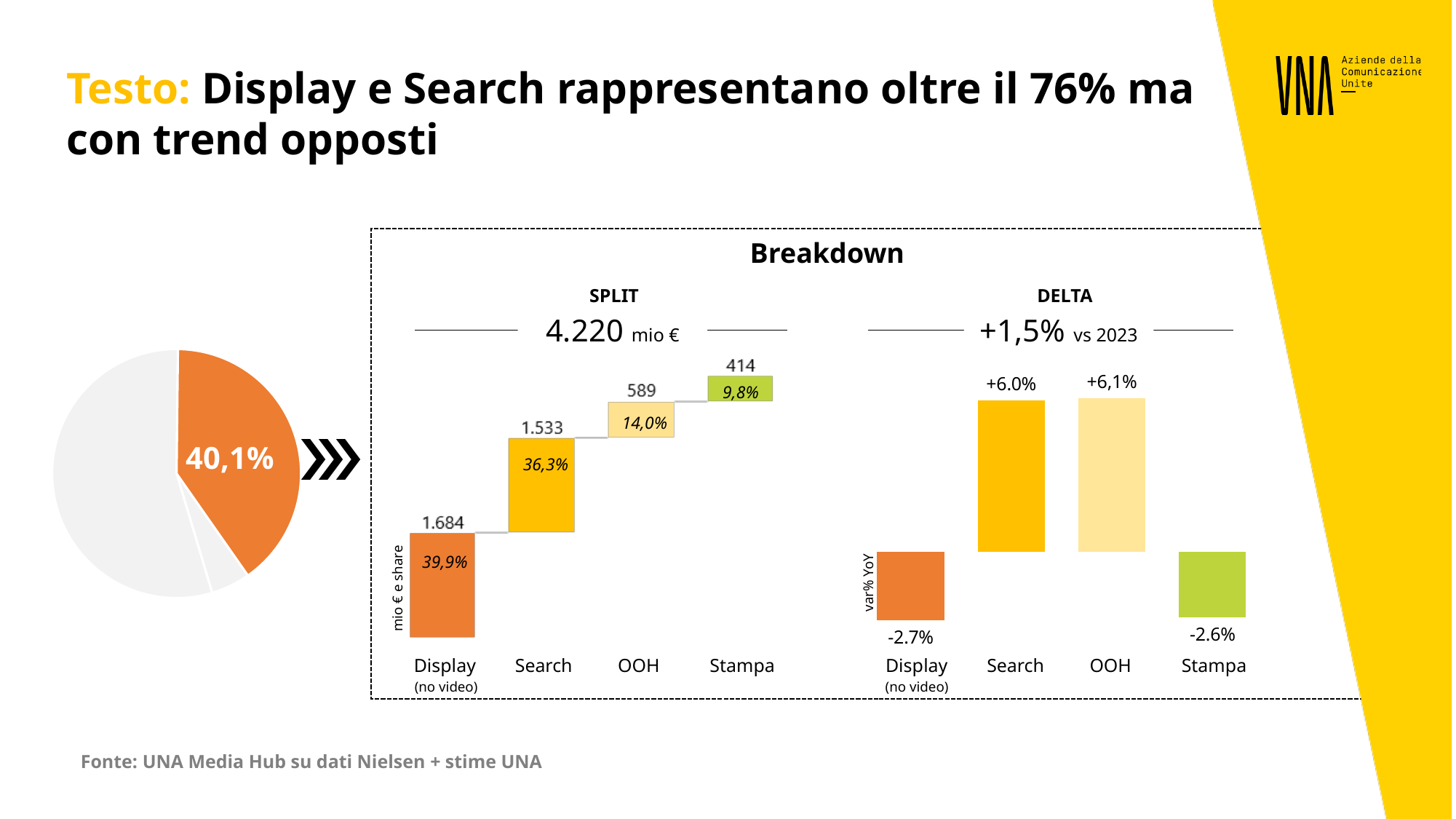
In the SPLIT chart, which category has the highest value? Display (no video) In the SPLIT chart, which is larger, the value for OOH or the value for Stampa? OOH In the SPLIT chart, what is the value for Display (no video)? 1.684 In the SPLIT chart, what is the total shown above the chart? 4.220 mio € In the SPLIT chart, which category has the lowest value? Stampa What kind of chart is the DELTA chart? bar chart In the SPLIT chart, what is the difference between the Display value and the Search value? 151 In the DELTA chart, what is the value for Stampa? -2.6% In the pie chart on the left, what share does the orange slice represent? 40,1% How many categories are shown in the SPLIT chart? 4 In the SPLIT chart, what share is shown for OOH? 14,0% In the DELTA chart, what is the value for Search? +6.0%